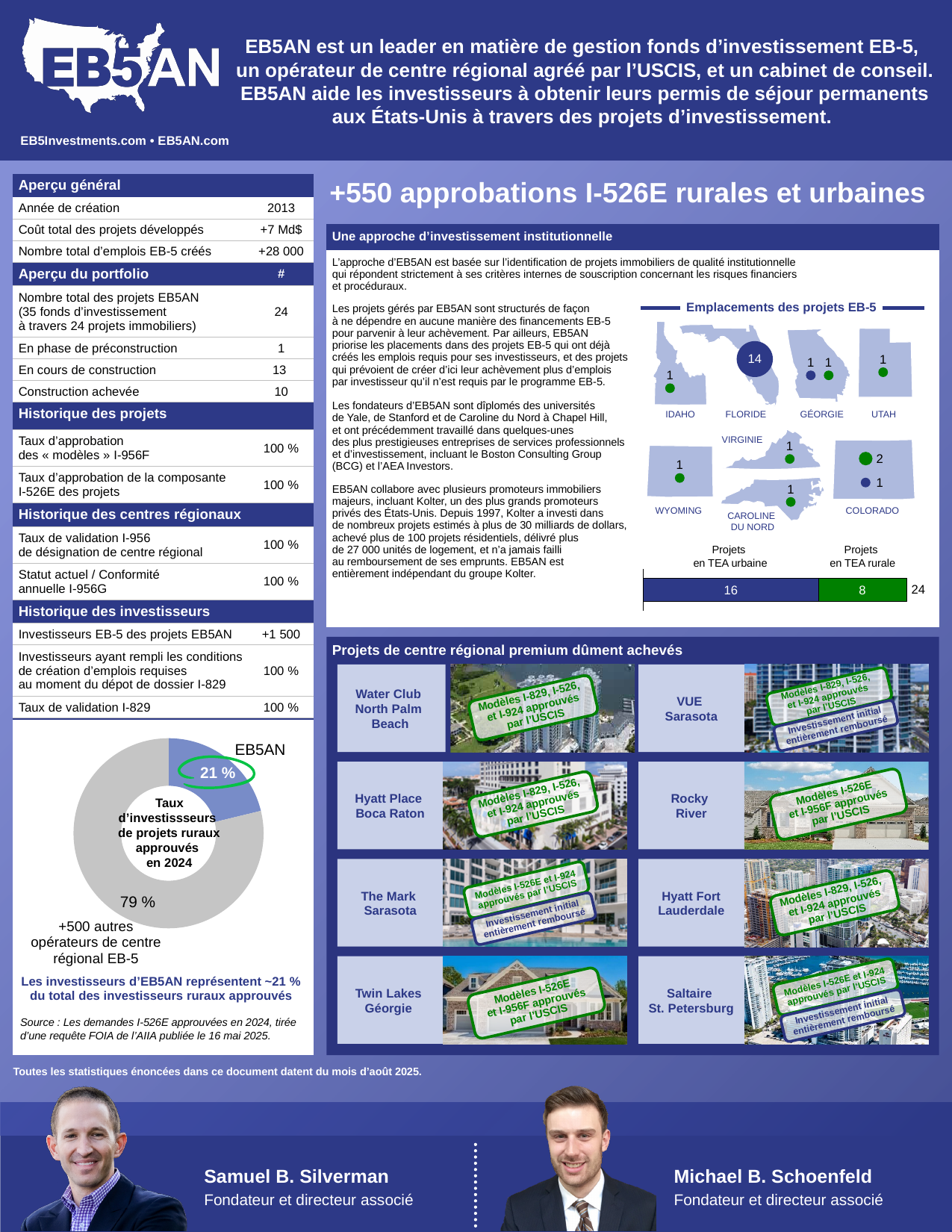
In the stacked bar under the project locations map, what is the difference between urban TEA and rural TEA projects? 8 In the donut chart on the left, what is the difference in percentage points between the other operators' share and EB5AN's share? 58 percentage points In the stacked bar under the project locations map, which category has more projects: urban TEA or rural TEA? Urban TEA In the donut chart on the left, what share of approved rural project investors does EB5AN represent? 21 % On the project locations map, which state has the highest number of EB-5 projects? Florida (14) In the stacked bar under the project locations map, how many projects are in urban TEAs? 16 In the stacked bar under the project locations map, how many projects are in rural TEAs? 8 In the stacked bar under the project locations map, what is the total number of projects? 24 In the donut chart on the left, which segment is larger: EB5AN or the other EB-5 regional center operators? Other EB-5 regional center operators In the donut chart on the left, what share is attributed to the +500 other EB-5 regional center operators? 79 % In the donut chart on the left, how many segments are shown? 2 What type of chart is used on the left to show the share of approved rural project investors in 2024? Pie (donut) chart